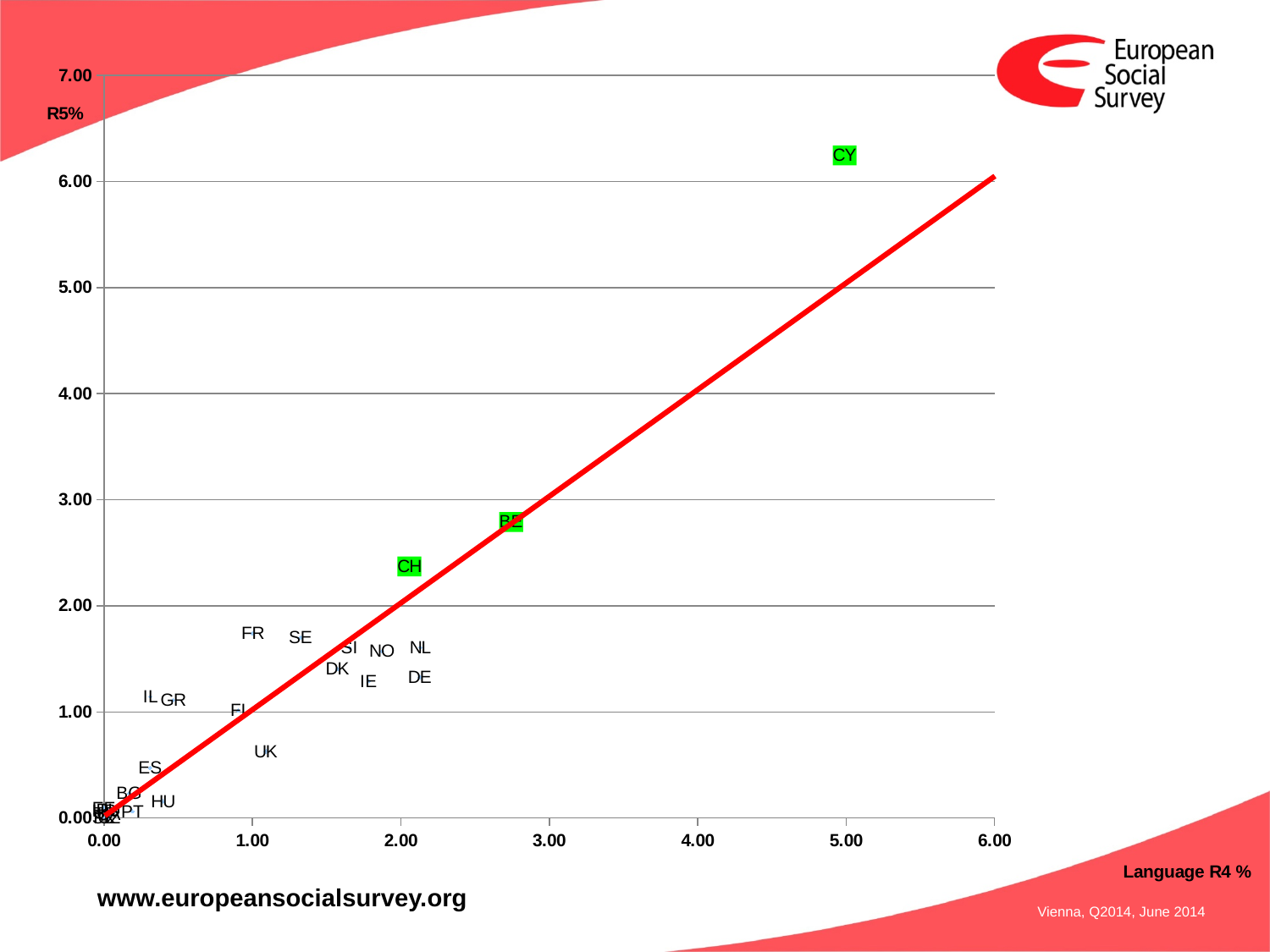
Which has the higher Language R4 % value, CY or BE? CY Is the R5% value for FR greater or less than 2.00? less Is the R5% value for CH greater or less than 2.00? greater Is the R5% value for CY greater or less than 6.00? greater Which country has the highest R5% value? CY What is the label of the horizontal axis? Language R4 % Which has the higher R5% value, BE or CH? BE What kind of chart is shown on the slide? scatter plot Which three country labels are highlighted in green? CY, BE, CH